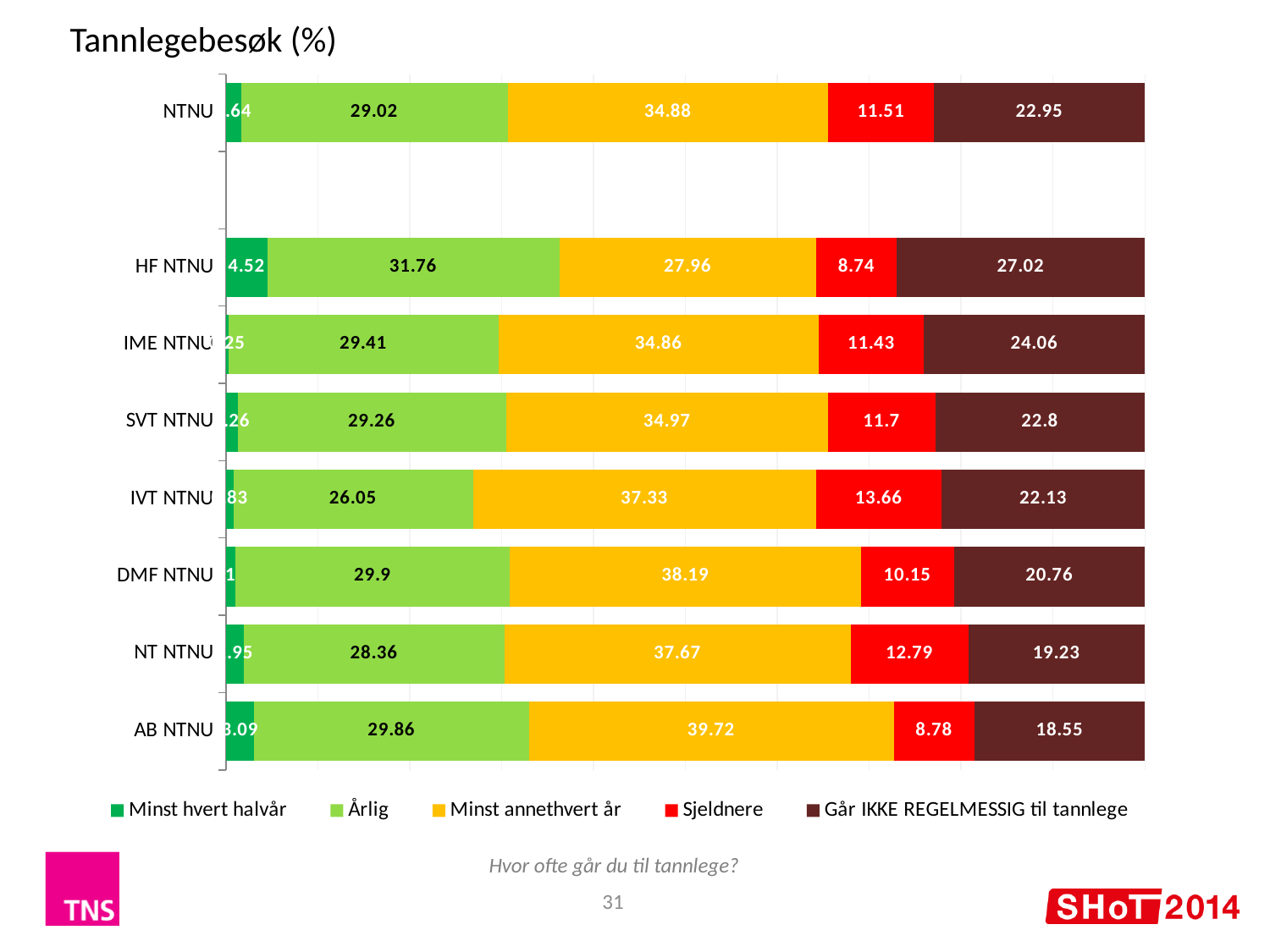
What is the value of the Årlig segment for HF NTNU? 31.76 Which category has the highest value for Minst annethvert år? AB NTNU What is the difference between the Går IKKE REGELMESSIG til tannlege values for HF NTNU and NTNU? 4.07 Which category has the highest value for Sjeldnere? IVT NTNU What is the value of the Sjeldnere segment for IVT NTNU? 13.66 How many series does the legend list? 5 How many categories are shown on the chart? 8 What is the value of the Går IKKE REGELMESSIG til tannlege segment for NT NTNU? 19.23 What is the value of the Minst annethvert år segment for AB NTNU? 39.72 Which category has the highest value for Årlig? HF NTNU Which category has the lowest value for Går IKKE REGELMESSIG til tannlege? AB NTNU Which has a larger Årlig value, HF NTNU or IME NTNU? HF NTNU